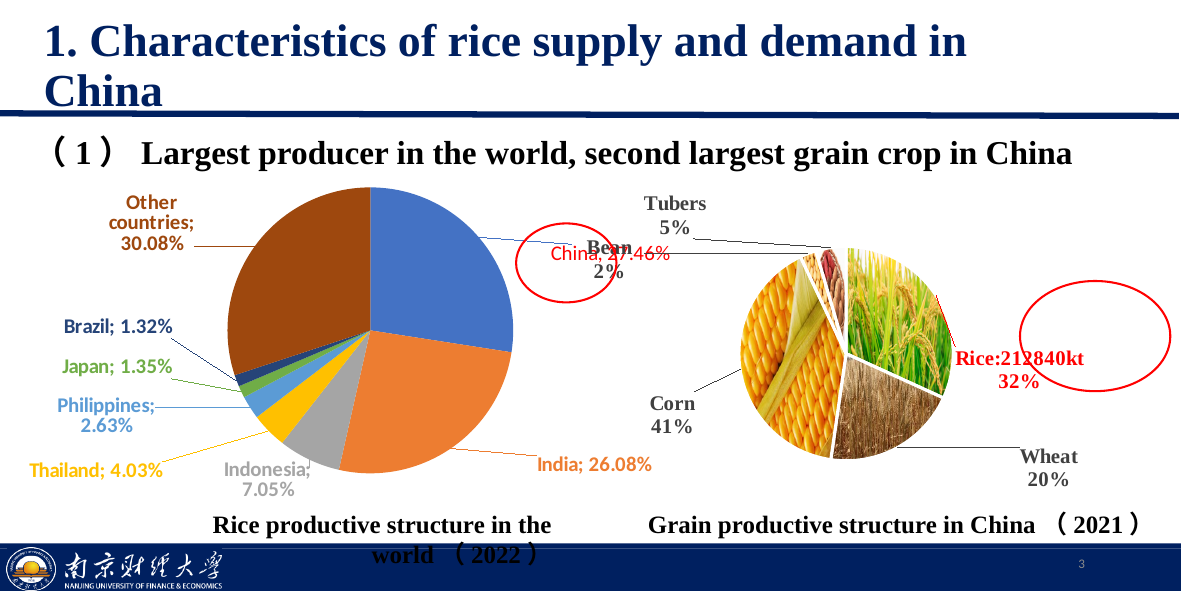
In the 'Rice productive structure in the world (2022)' chart, what share does India have? 26.08% In the 'Rice productive structure in the world (2022)' chart, how many slices are labelled? 8 In the 'Grain productive structure in China (2021)' chart, what share does Corn have? 41% What type of chart is the 'Rice productive structure in the world (2022)' chart? Pie chart In the 'Grain productive structure in China (2021)' chart, what is the difference between the Corn and Wheat shares? 21% In the 'Rice productive structure in the world (2022)' chart, what share does China have? 27.46% In the 'Rice productive structure in the world (2022)' chart, which country has the smallest share? Brazil In the 'Grain productive structure in China (2021)' chart, which grain has the smallest share? Bean In the 'Rice productive structure in the world (2022)' chart, which labelled slice is the largest? Other countries In the 'Grain productive structure in China (2021)' chart, what share does Rice have? 32% In the 'Rice productive structure in the world (2022)' chart, what share does Thailand have? 4.03% In the 'Rice productive structure in the world (2022)' chart, what is the difference between China's and India's shares? 1.38%